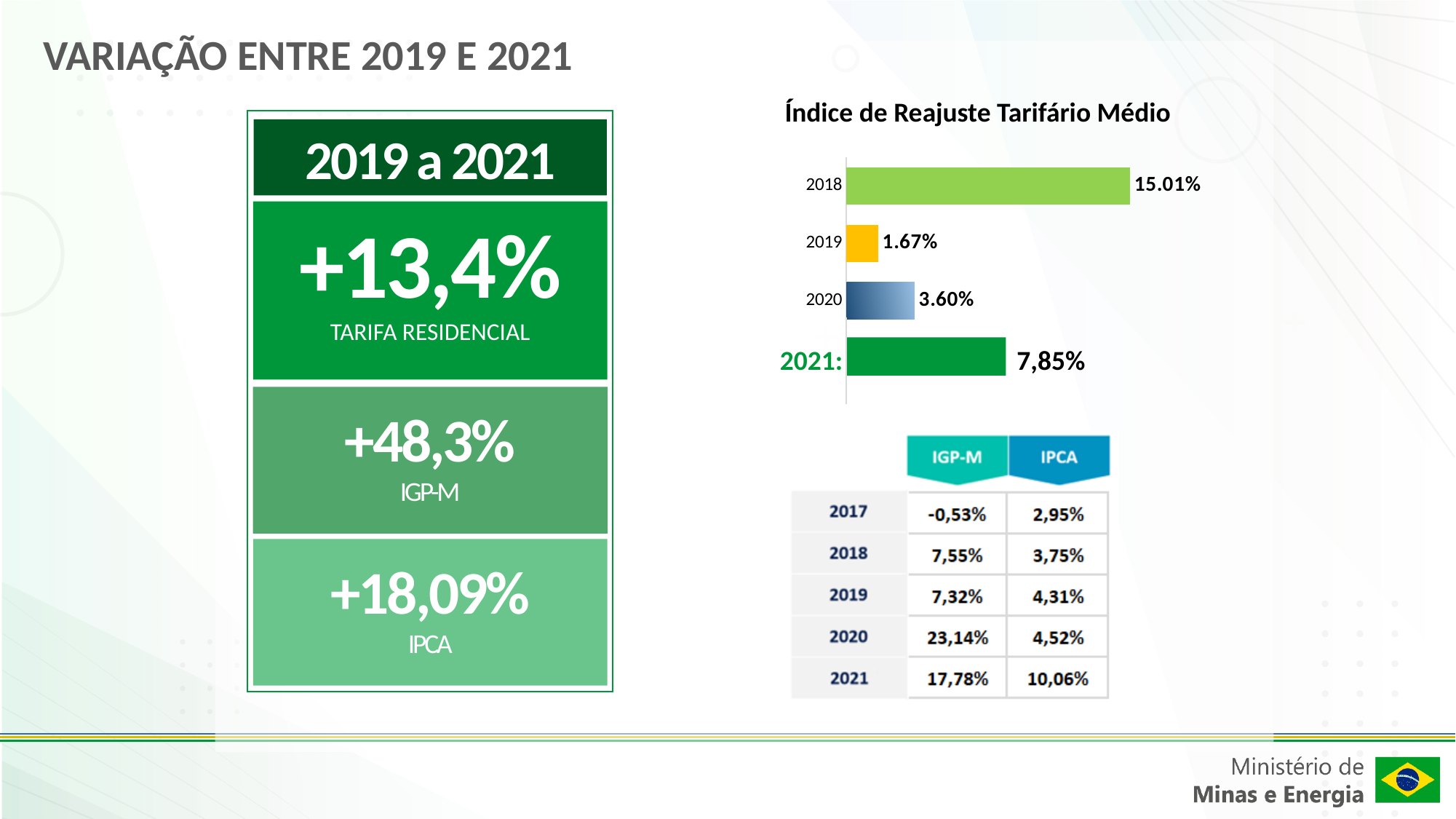
In the "Índice de Reajuste Tarifário Médio" chart, which year has the highest value? 2018 In the "Índice de Reajuste Tarifário Médio" chart, what is the value for 2019? 1.67% In the "Índice de Reajuste Tarifário Médio" chart, do the values rise or fall from 2019 to 2021? rise In the "Índice de Reajuste Tarifário Médio" chart, what is the difference between the 2018 value and the 2019 value? 13.34% In the "Índice de Reajuste Tarifário Médio" chart, what is the value for 2021? 7,85% In the "Índice de Reajuste Tarifário Médio" chart, what is the value for 2020? 3.60% How many years (bars) are shown in the "Índice de Reajuste Tarifário Médio" chart? 4 In the "Índice de Reajuste Tarifário Médio" chart, what is the value for 2018? 15.01% What is the title of the bar chart on the slide? Índice de Reajuste Tarifário Médio In the "Índice de Reajuste Tarifário Médio" chart, which year has the lowest value? 2019 In the "Índice de Reajuste Tarifário Médio" chart, which is larger, the value for 2020 or the value for 2021? 2021 What kind of chart is shown under the title "Índice de Reajuste Tarifário Médio"? bar chart